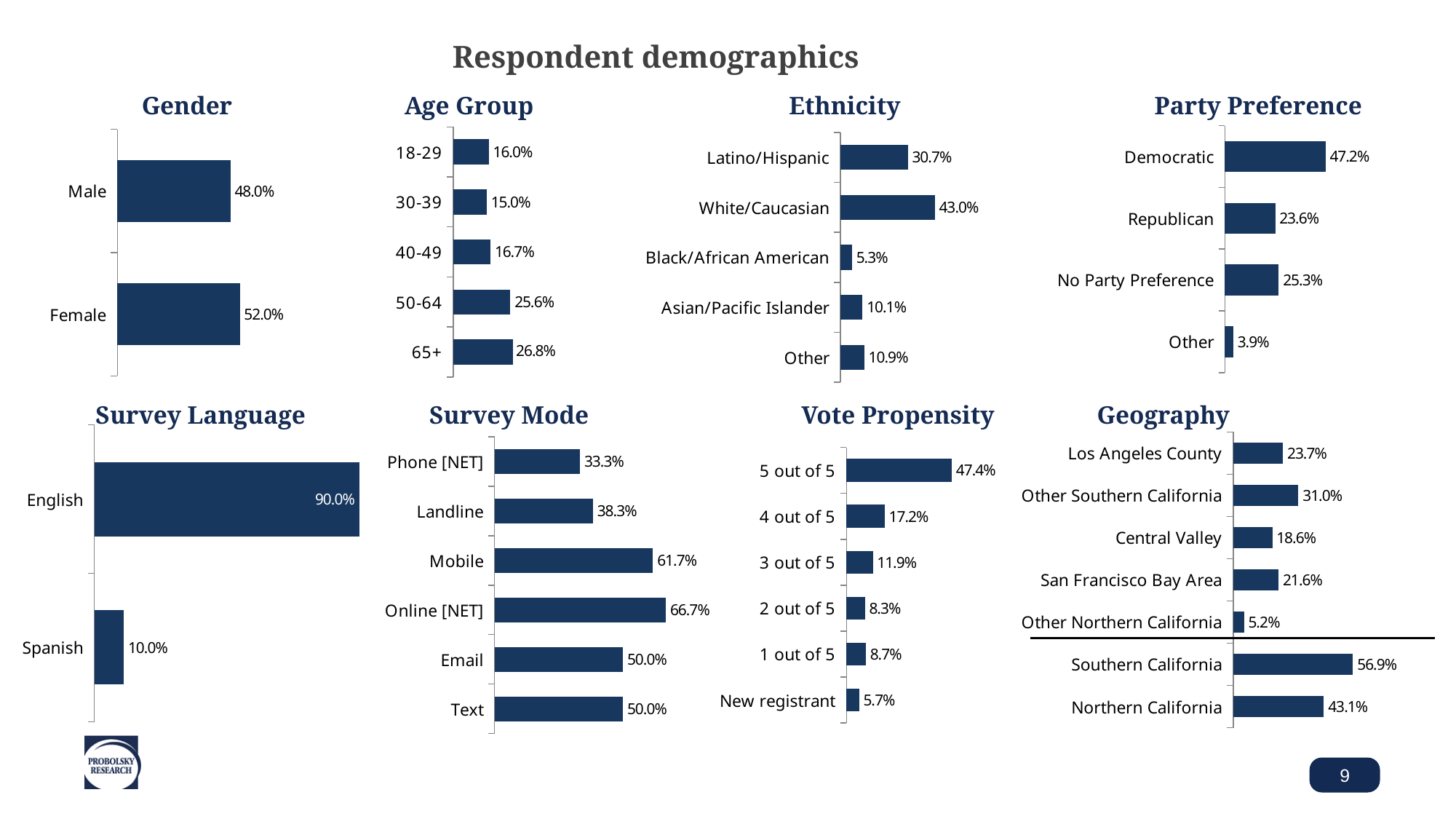
In the Party Preference chart, what is the difference between Democratic and Republican? 23.6% In the Survey Mode chart, what is the value for Mobile? 61.7% In the Age Group chart, which age group has the lowest value? 30-39 In the Vote Propensity chart, which category has the lowest value? New registrant In the Geography chart, what is the value for Central Valley? 18.6% In the Ethnicity chart, what is the value for Asian/Pacific Islander? 10.1% In the Party Preference chart, which is larger, Republican or No Party Preference? No Party Preference In the Age Group chart, which age group has the highest value? 65+ In the Gender chart, what is the value for Female? 52.0% In the Survey Language chart, how many categories are shown? 2 In the Geography chart, what is the difference between Southern California and Northern California? 13.8% What kind of chart is the Ethnicity chart? Bar chart